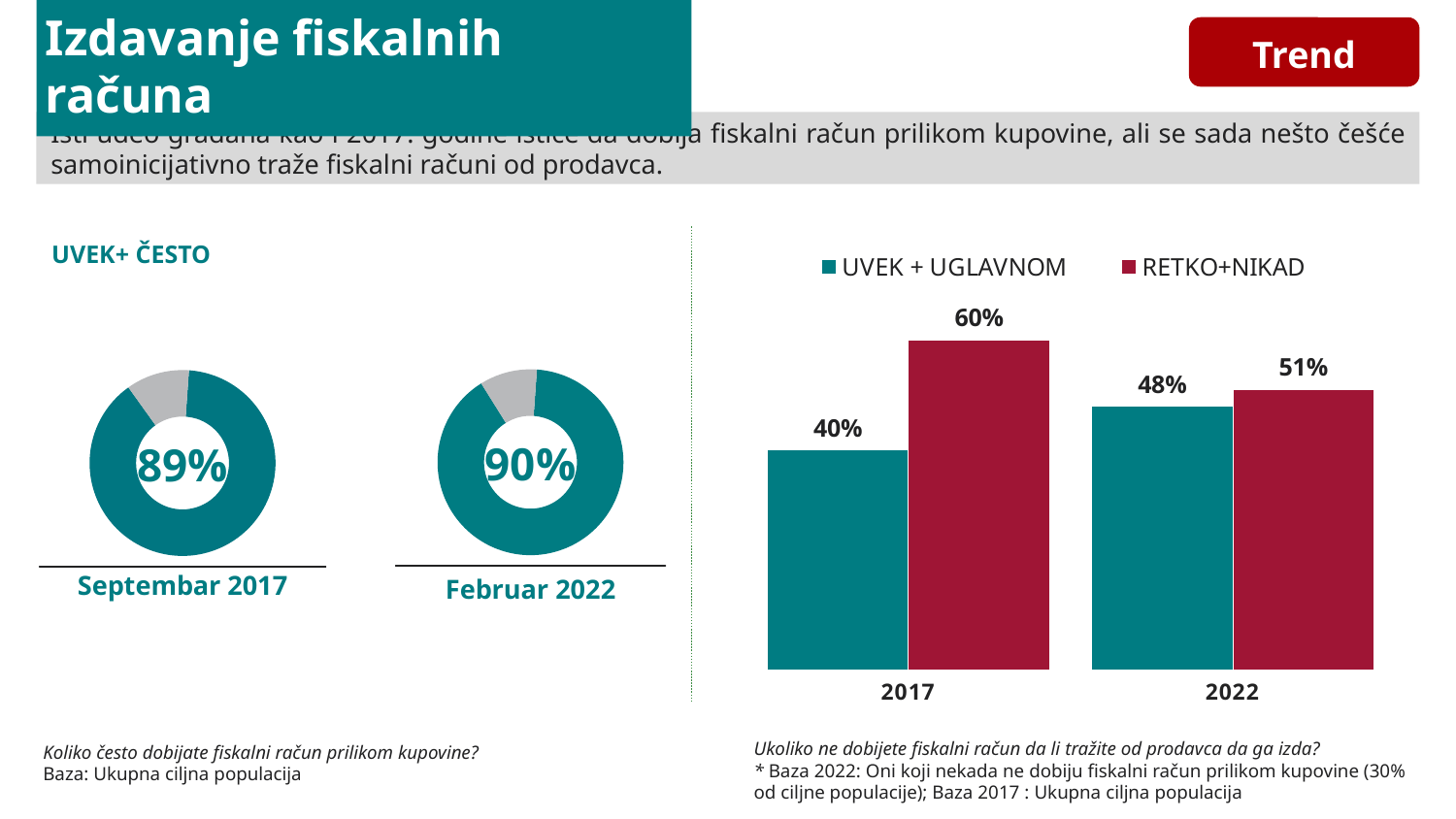
In the bar chart on the right, what is the value for RETKO+NIKAD in 2022? 51% What kind of chart is shown on the right side of the slide? bar chart In the bar chart on the right, what is the value for UVEK + UGLAVNOM in 2017? 40% In the bar chart on the right, how many series does the legend list? 2 What is the difference between the percentages shown in the Februar 2022 and Septembar 2017 donut charts? 1% In the bar chart on the right, what is the value for UVEK + UGLAVNOM in 2022? 48% In the donut chart labelled Septembar 2017, what percentage is shown in the centre? 89% Comparing the two donut charts on the left, which period shows the higher percentage, Septembar 2017 or Februar 2022? Februar 2022 In the bar chart on the right, what is the difference between RETKO+NIKAD and UVEK + UGLAVNOM in 2017? 20% In the donut chart labelled Februar 2022, what percentage is shown in the centre? 90% In the bar chart on the right, does the value for UVEK + UGLAVNOM rise or fall from 2017 to 2022? rise In the bar chart on the right, what is the value for RETKO+NIKAD in 2017? 60%